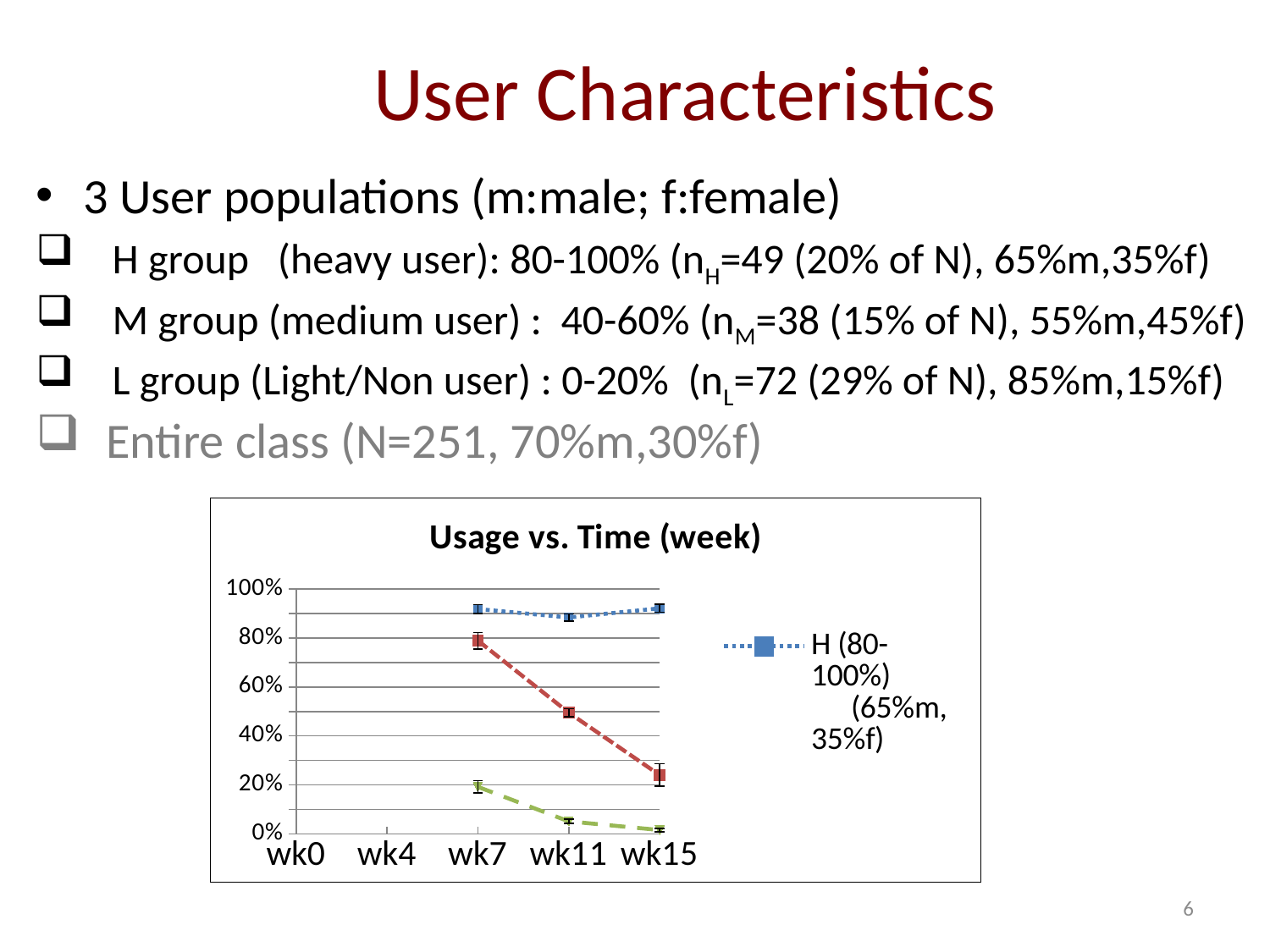
Is the value of the H (80-100%) series at wk7 greater or less than 80%? greater How many week labels are shown on the x axis of the chart? 5 Is the value of the red dashed series at wk15 greater or less than 40%? less Which series has the highest value at wk11? H (80-100%) What is the title of the chart? Usage vs. Time (week) Is the value of the green dashed series at wk7 greater or less than 40%? less How many series does the chart's legend list? 1 At wk15, which is larger: the H (80-100%) series or the red dashed series? H (80-100%) What kind of chart is shown on the slide? line chart Does the green dashed series rise or fall from wk7 to wk15? fall Does the red dashed series rise or fall from wk7 to wk15? fall